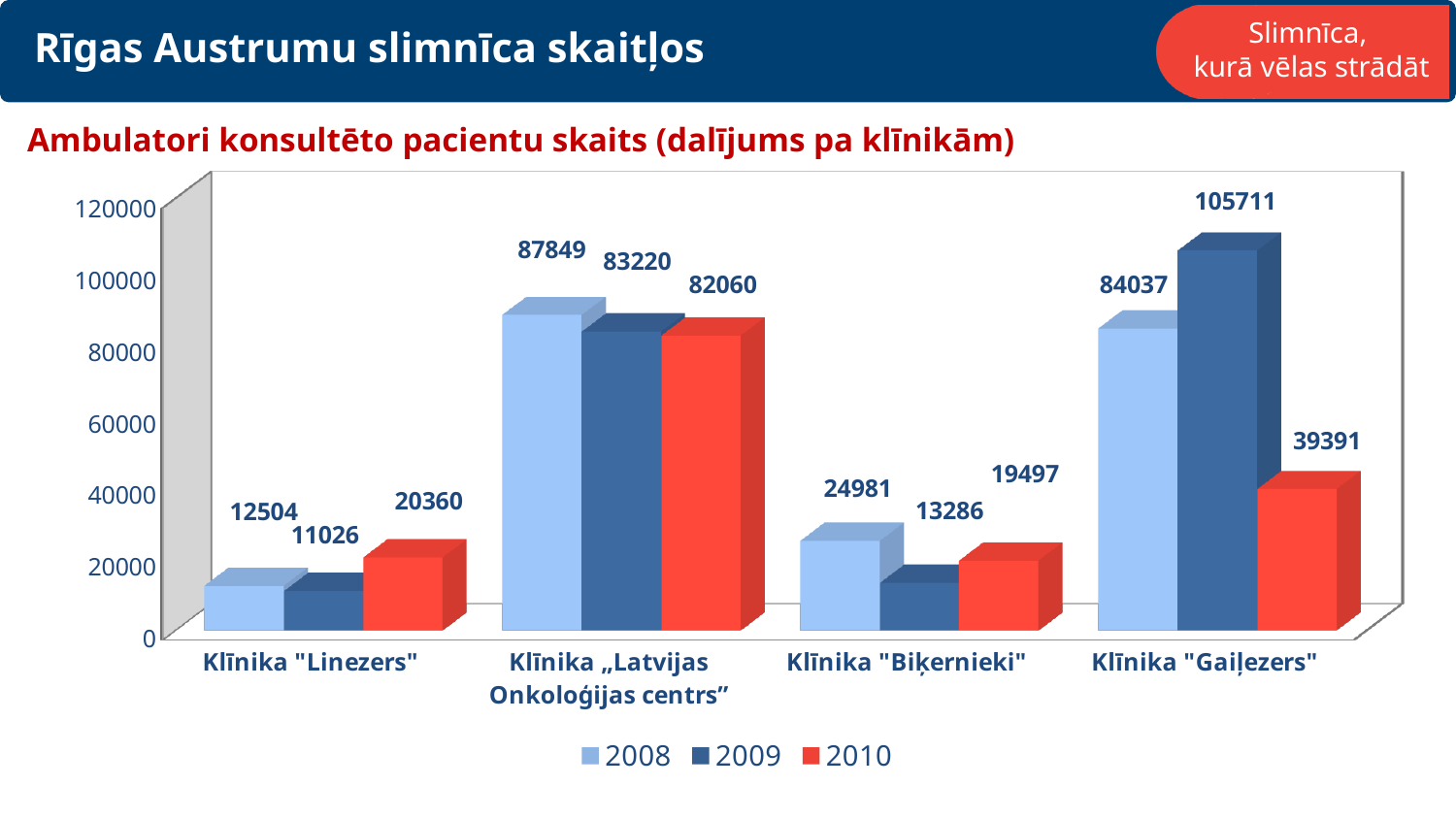
Is the 2008 value for Klīnika „Latvijas Onkoloģijas centrs” greater or less than 80000? greater What is the difference between the 2009 and 2010 values for Klīnika "Gaiļezers"? 66320 Which is larger for Klīnika "Biķernieki": the 2009 value or the 2010 value? 2010 Which clinic has the highest value in 2010? Klīnika „Latvijas Onkoloģijas centrs” Do the values for Klīnika „Latvijas Onkoloģijas centrs” rise or fall from 2008 to 2010? fall Which clinic has the lowest value in 2009? Klīnika "Linezers" How many clinics are shown on the x axis? 4 What kind of chart is shown on the slide? bar chart How many series does the legend list? 3 What is the value for Klīnika "Linezers" in 2010? 20360 What is the value for Klīnika "Gaiļezers" in 2009? 105711 What is the value for Klīnika "Biķernieki" in 2008? 24981